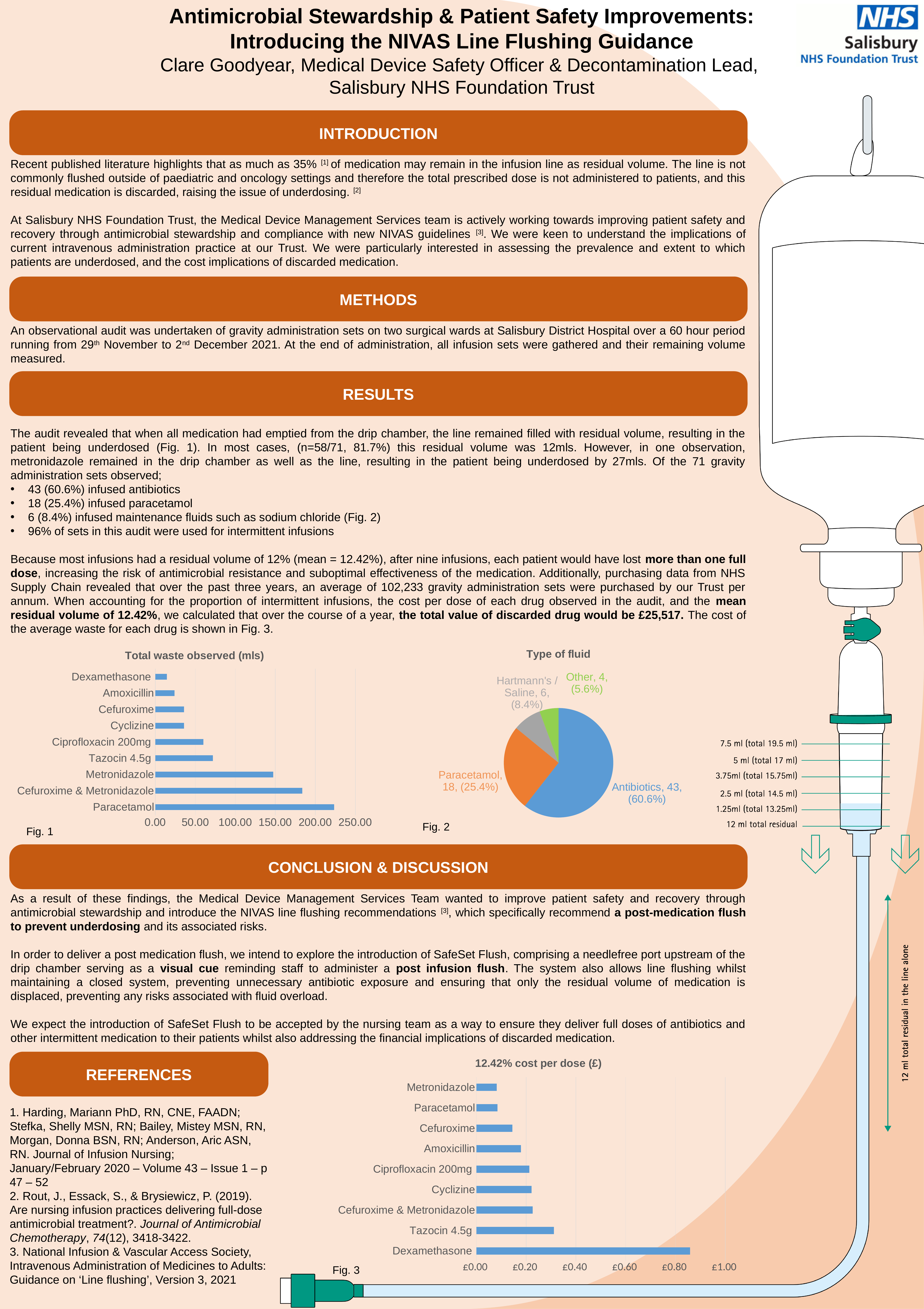
What kind of chart is the '12.42% cost per dose (£)' chart? bar chart In the '12.42% cost per dose (£)' chart, is the value for Tazocin 4.5g greater or less than £0.20? greater In the 'Type of fluid' pie chart, how many slices are there? 4 In the 'Type of fluid' pie chart, what share of the pie is Paracetamol? 25.4% In the 'Total waste observed (mls)' chart, is the value for Cefuroxime & Metronidazole greater or less than 150.00? greater In the 'Total waste observed (mls)' chart, which category has the lowest value? Dexamethasone In the 'Total waste observed (mls)' chart, how many categories are plotted? 9 In the 'Type of fluid' pie chart, what is the difference between the Antibiotics count and the Paracetamol count? 25 In the '12.42% cost per dose (£)' chart, which category has the highest value? Dexamethasone In the 'Total waste observed (mls)' chart, which category has the highest value? Paracetamol In the 'Type of fluid' pie chart, how many sets infused antibiotics? 43 In the 'Type of fluid' pie chart, which category has the smallest slice? Other